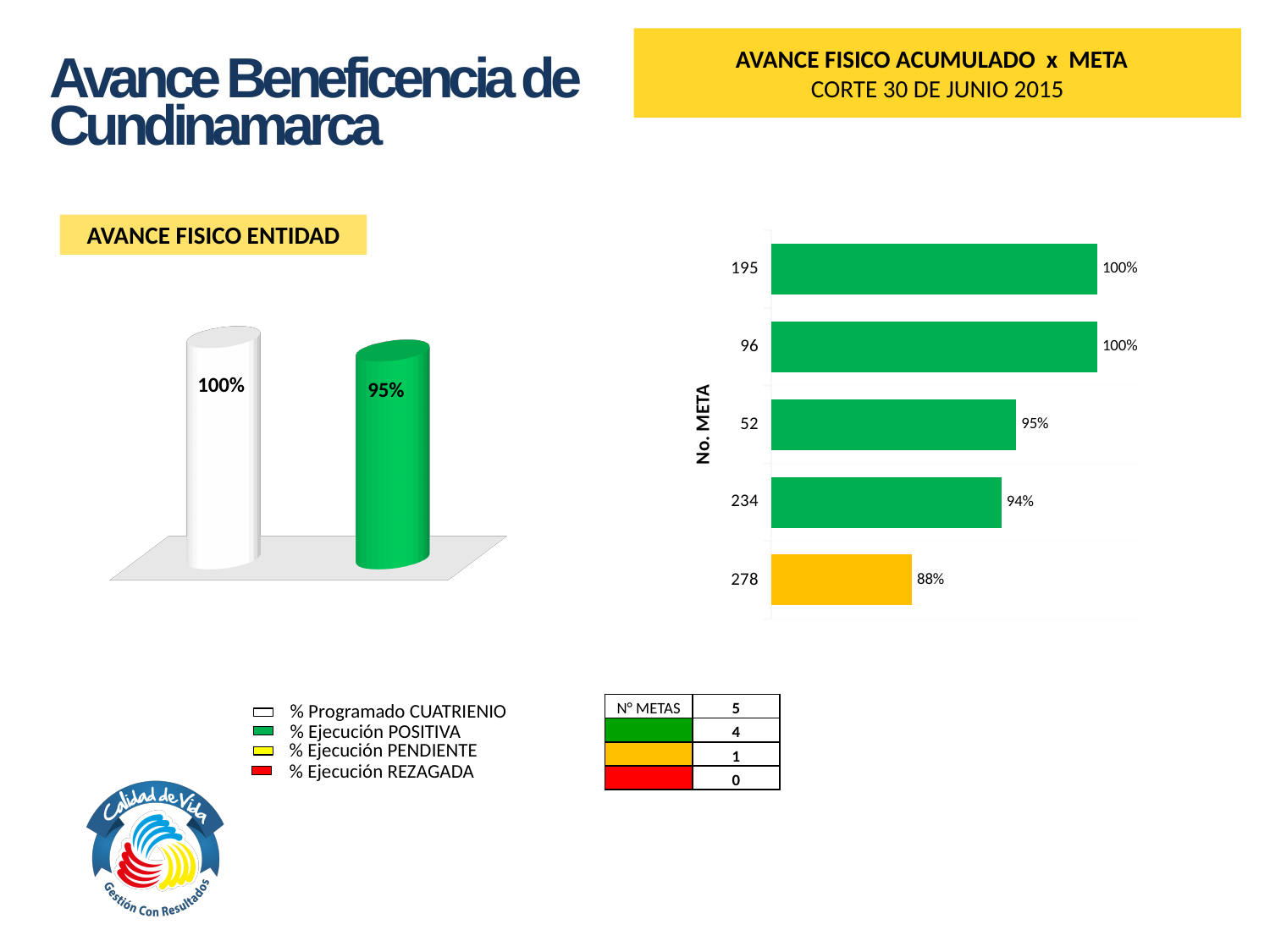
In the AVANCE FISICO ENTIDAD chart, what is the value of the green bar? 95% In the AVANCE FISICO ACUMULADO x META chart, what is the value for meta 234? 94% What kind of chart is the AVANCE FISICO ACUMULADO x META chart? Bar chart In the AVANCE FISICO ACUMULADO x META chart, which meta has the lowest value? 278 What is the label of the vertical axis in the AVANCE FISICO ACUMULADO x META chart? No. META In the AVANCE FISICO ACUMULADO x META chart, what is the value for meta 278? 88% In the AVANCE FISICO ACUMULADO x META chart, which is larger, the value for meta 52 or the value for meta 234? 52 In the AVANCE FISICO ACUMULADO x META chart, which meta is shown with a yellow bar? 278 In the AVANCE FISICO ENTIDAD chart, what is the difference between the white bar and the green bar? 5% In the AVANCE FISICO ACUMULADO x META chart, what is the value for meta 52? 95% How many metas are shown in the AVANCE FISICO ACUMULADO x META chart? 5 In the AVANCE FISICO ACUMULADO x META chart, what is the difference between the values for meta 195 and meta 278? 12%